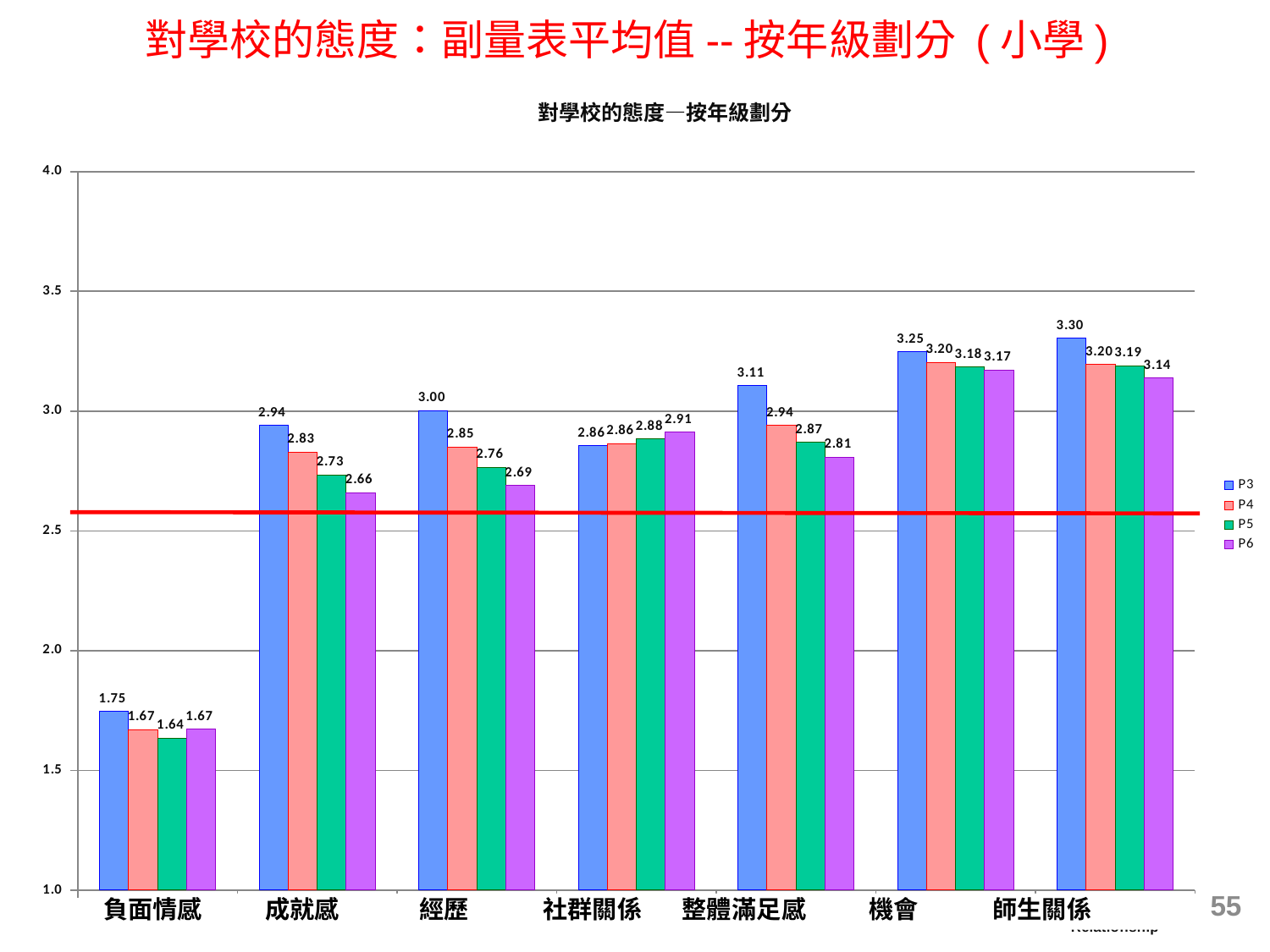
How many categories are shown on the x axis? 7 What is the value for P3 in the 師生關係 category? 3.30 Is the value for P6 in the 機會 category greater or less than 3.0? greater What is the difference between the P3 and P6 values in the 成就感 category? 0.28 What kind of chart is shown on the slide? bar chart What is the value for P5 in the 負面情感 category? 1.64 How many series does the legend list? 4 What is the value for P4 in the 整體滿足感 category? 2.94 Which is larger in the 經歷 category, the P3 value or the P4 value? P3 Which category has the lowest value for P3? 負面情感 Which category has the highest value for P3? 師生關係 What is the value for P6 in the 社群關係 category? 2.91